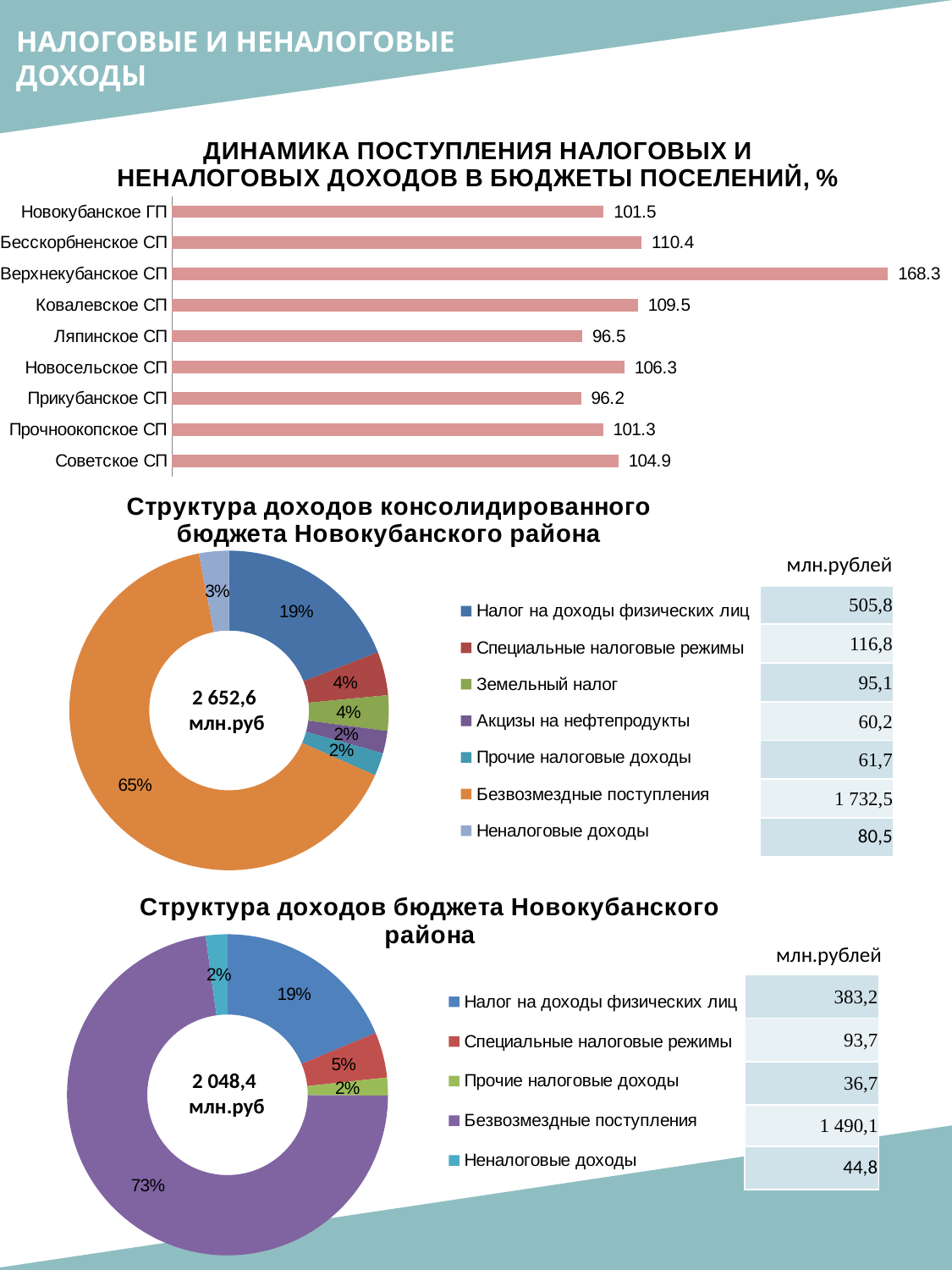
How many categories does the legend list in the chart 'Структура доходов консолидированного бюджета Новокубанского района'? 7 How many settlements are shown in the bar chart 'Динамика поступления налоговых и неналоговых доходов в бюджеты поселений, %'? 9 What total is shown in the centre of the chart 'Структура доходов бюджета Новокубанского района'? 2 048,4 млн.руб In the chart 'Структура доходов консолидированного бюджета Новокубанского района', what share does Безвозмездные поступления have? 65% In the bar chart 'Динамика поступления налоговых и неналоговых доходов в бюджеты поселений, %', what is the difference between Бесскорбненское СП and Ковалевское СП? 0.9 In the chart 'Структура доходов бюджета Новокубанского района', what is the value in млн.рублей for Безвозмездные поступления? 1 490,1 In the bar chart 'Динамика поступления налоговых и неналоговых доходов в бюджеты поселений, %', what is the value for Верхнекубанское СП? 168.3 In the bar chart 'Динамика поступления налоговых и неналоговых доходов в бюджеты поселений, %', which settlement has the lowest value? Прикубанское СП In the bar chart 'Динамика поступления налоговых и неналоговых доходов в бюджеты поселений, %', which is larger: Новосельское СП or Советское СП? Новосельское СП In the chart 'Структура доходов консолидированного бюджета Новокубанского района', what is the value in млн.рублей for Налог на доходы физических лиц? 505,8 What type of chart is 'Динамика поступления налоговых и неналоговых доходов в бюджеты поселений, %'? Bar chart In the bar chart 'Динамика поступления налоговых и неналоговых доходов в бюджеты поселений, %', which settlement has the highest value? Верхнекубанское СП